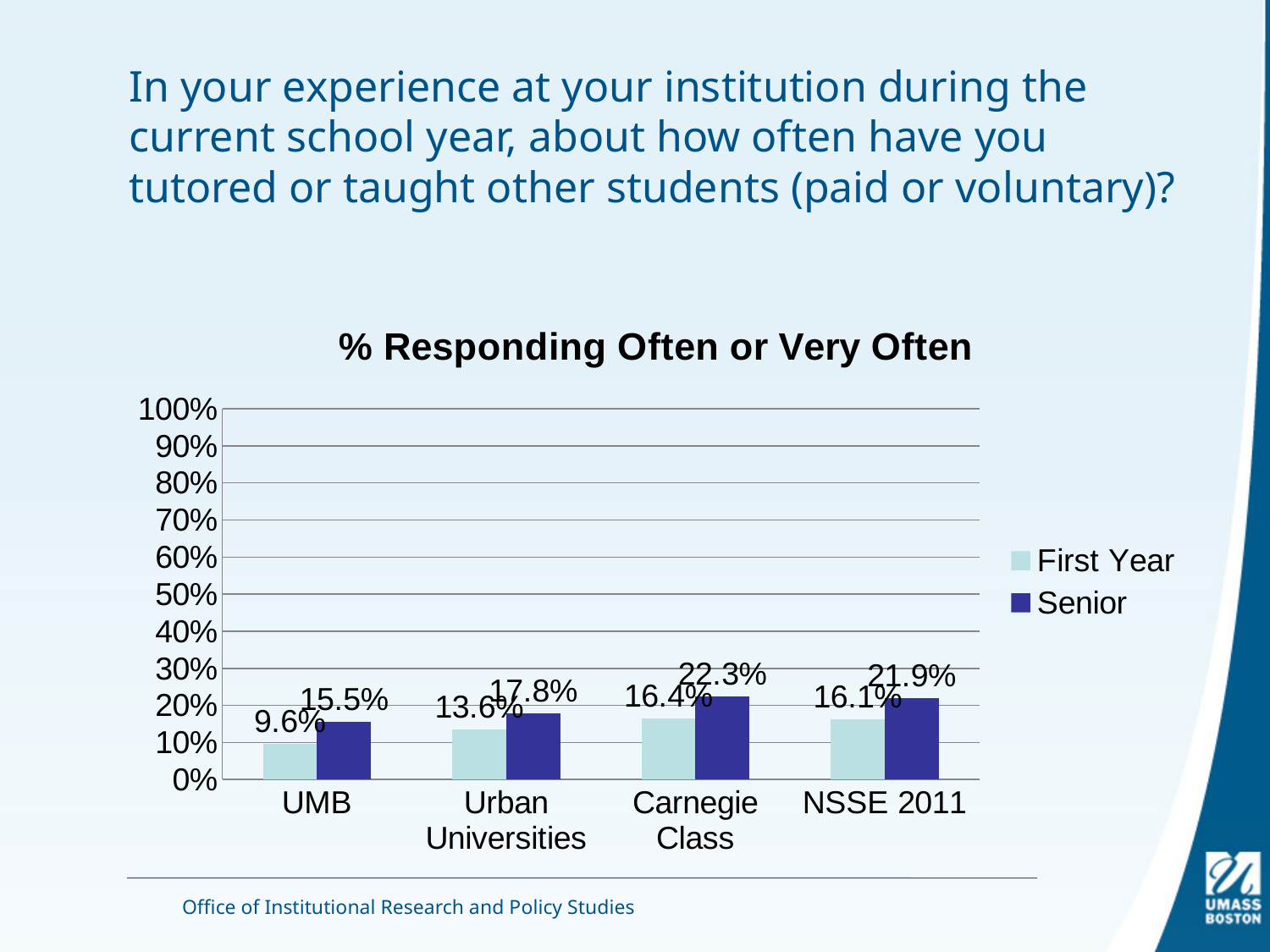
Which category has the lowest Senior value? UMB Which category has the lowest First Year value? UMB What is the First Year value for Carnegie Class? 16.4% How many series does the legend list? 2 What is the Senior value for UMB? 15.5% What is the Senior value for NSSE 2011? 21.9% What is the First Year value for UMB? 9.6% What kind of chart is shown on the slide? Bar chart How many categories are shown on the x axis? 4 What is the Senior value for Urban Universities? 17.8% What is the difference between the Senior and First Year values for UMB? 5.9% Which is larger for Urban Universities, the First Year value or the Senior value? Senior